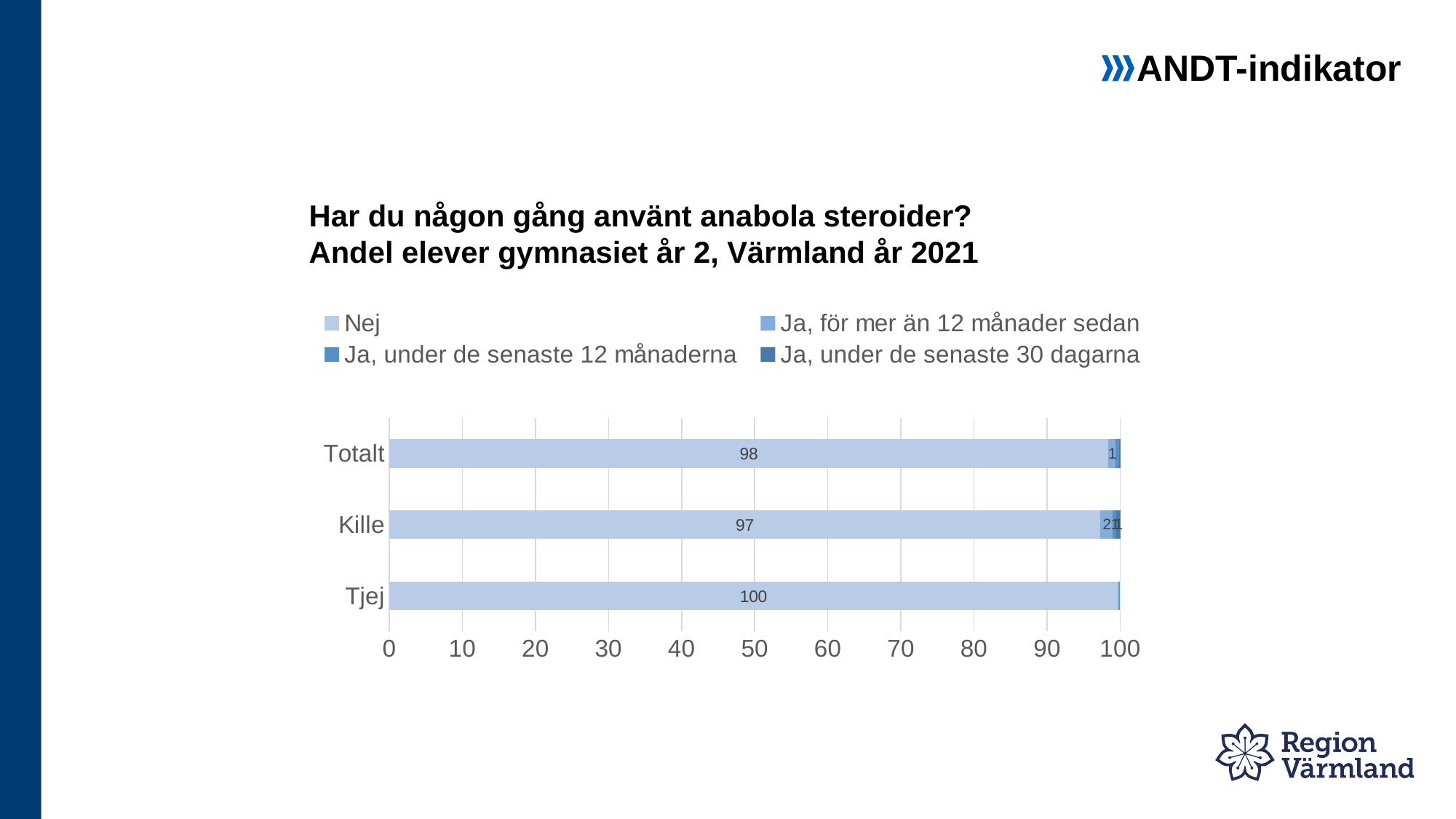
What is the value of the "Nej" segment for Totalt? 98 What is the value of the "Nej" segment for Kille? 97 Which category has the lowest "Nej" value? Kille Is the "Nej" value for Kille greater or less than 90? greater What is the difference between the "Nej" values for Tjej and Kille? 3 How many categories are shown on the y axis? 3 What kind of chart is shown on the slide? Stacked bar chart Which category has the highest "Nej" value? Tjej What is the value of the "Nej" segment for Tjej? 100 Which legend entry is listed first? Nej Which has a larger "Nej" value, Totalt or Kille? Totalt How many series does the legend list? 4